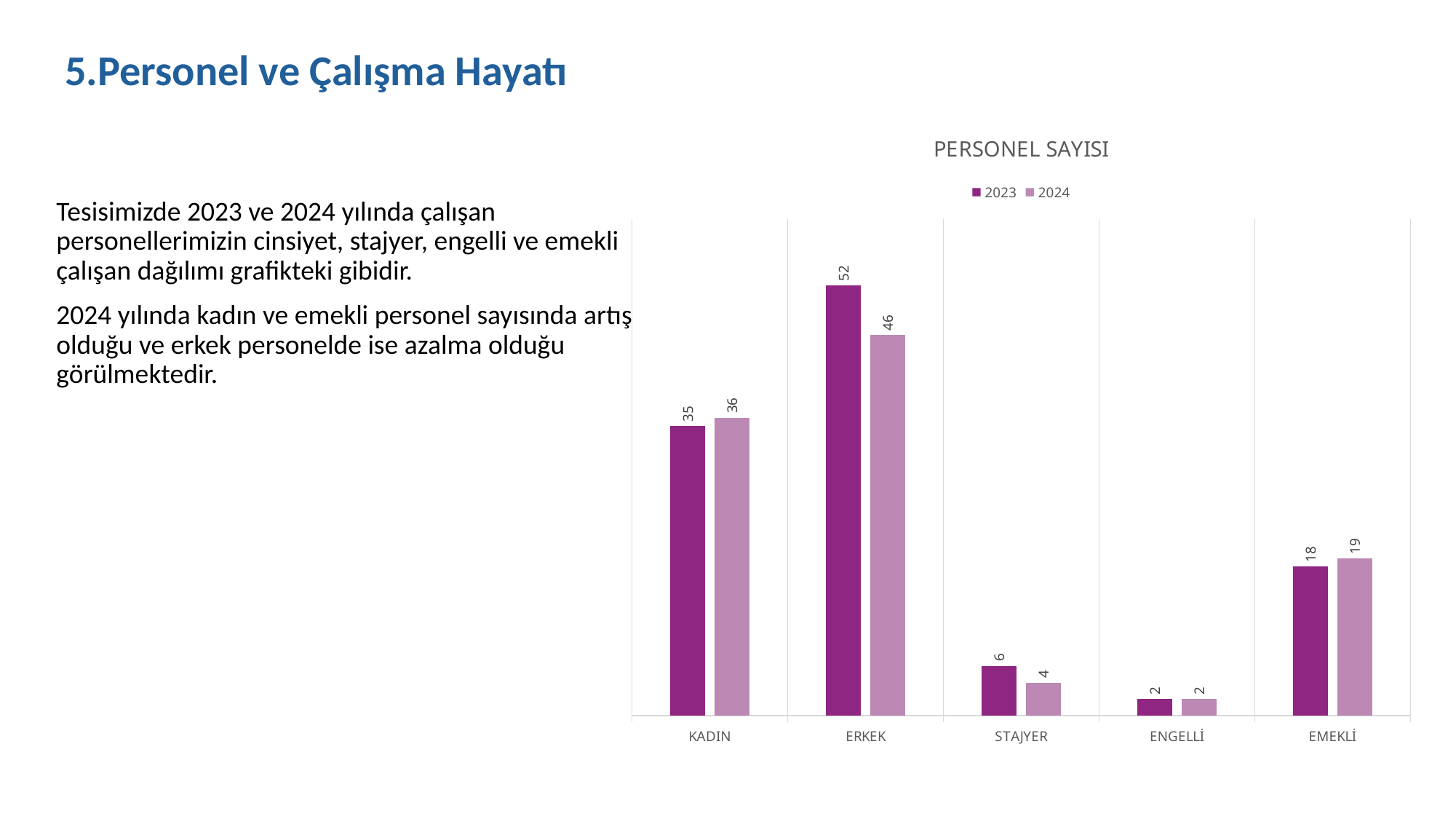
What kind of chart is shown on the slide? bar chart What is the value for STAJYER in the 2024 series? 4 Which category has the lowest value in the 2023 series? ENGELLİ How many categories are shown on the x axis? 5 Which category has the highest value in the 2024 series? ERKEK Which is larger for STAJYER, the 2023 value or the 2024 value? 2023 What is the difference between the 2023 and 2024 values for ERKEK? 6 What is the title of the chart? PERSONEL SAYISI How many series does the legend list? 2 What is the value for EMEKLİ in the 2023 series? 18 What is the value for ERKEK in the 2023 series? 52 What is the value for KADIN in the 2024 series? 36